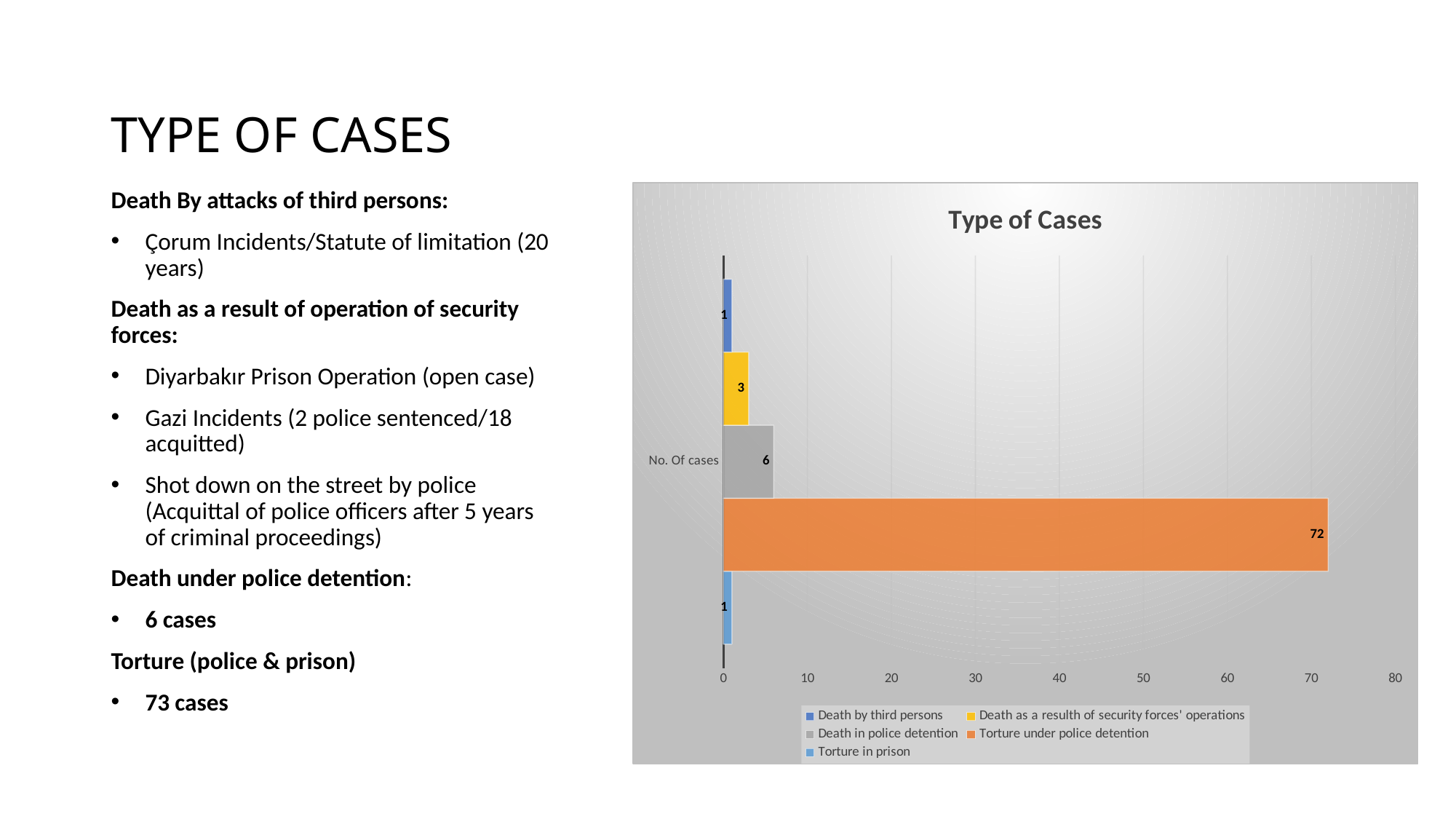
Which series has the highest value? Torture under police detention What is the difference between Torture under police detention and Death in police detention? 66 Is the value for Torture under police detention greater or less than 70? greater How many series does the chart legend list? 5 What is the value for Death as a result of security forces' operations? 3 What is the value for Death in police detention? 6 What is the title of the chart? Type of Cases What is the value for Torture under police detention? 72 What kind of chart is shown on the slide? bar chart Which is larger, Death in police detention or Death as a result of security forces' operations? Death in police detention What is the label of the category on the vertical axis? No. Of cases What is the value for Torture in prison? 1